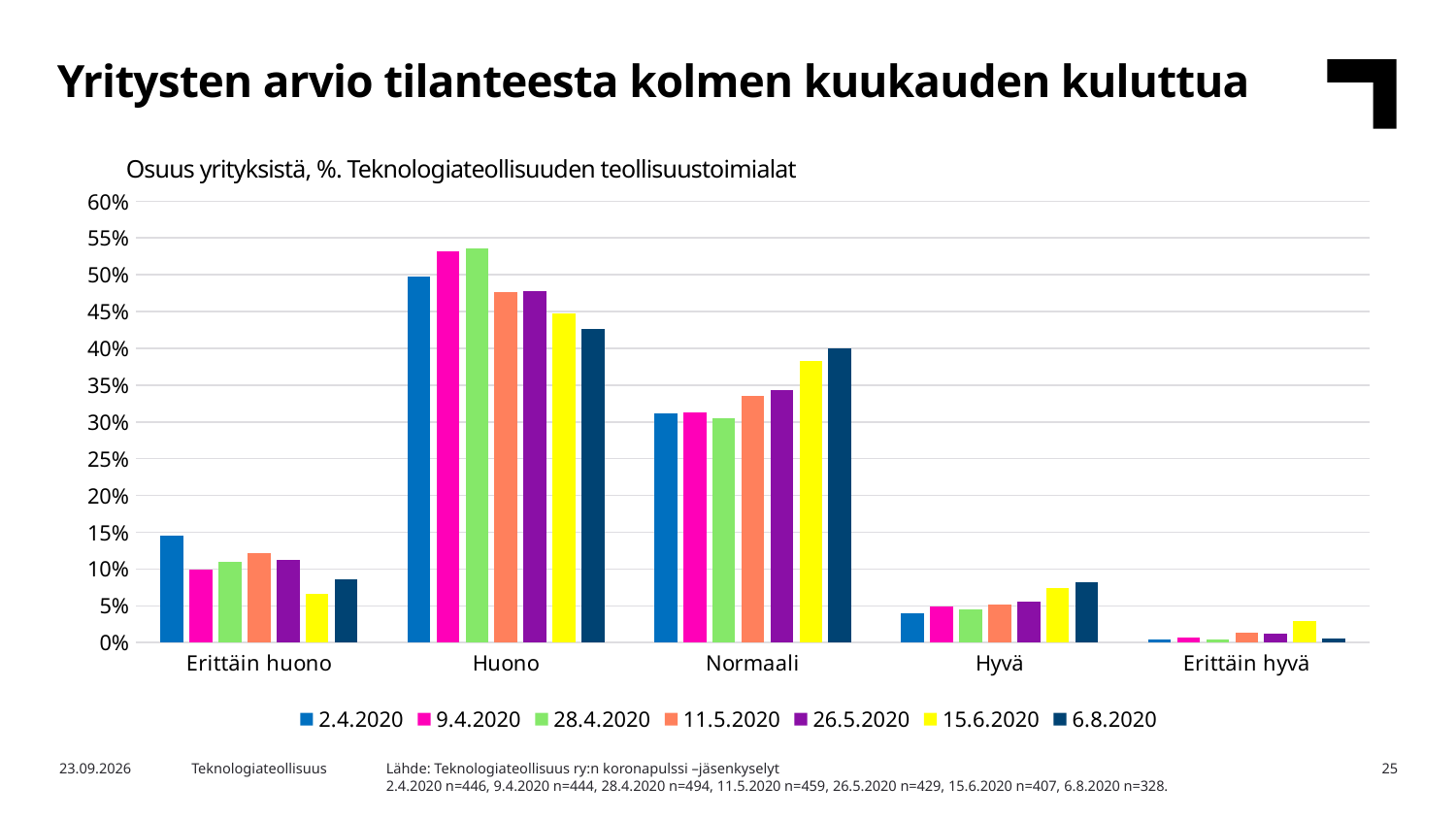
Is the value for Hyvä in the 6.8.2020 series greater or less than 5%? greater For the Normaali category, which is larger: the 2.4.2020 value or the 6.8.2020 value? 6.8.2020 Is the value for Erittäin huono in the 15.6.2020 series greater or less than 10%? less What kind of chart is shown on the slide? bar chart For the Huono category, do the values rise or fall from the 28.4.2020 series to the 6.8.2020 series? fall Which category has the highest value in the 2.4.2020 series? Huono What is the subtitle text shown above the chart? Osuus yrityksistä, %. Teknologiateollisuuden teollisuustoimialat Is the value for Huono in the 2.4.2020 series greater or less than 45%? greater How many series does the legend list? 7 Which category has the lowest value in the 6.8.2020 series? Erittäin hyvä How many categories are shown on the x axis? 5